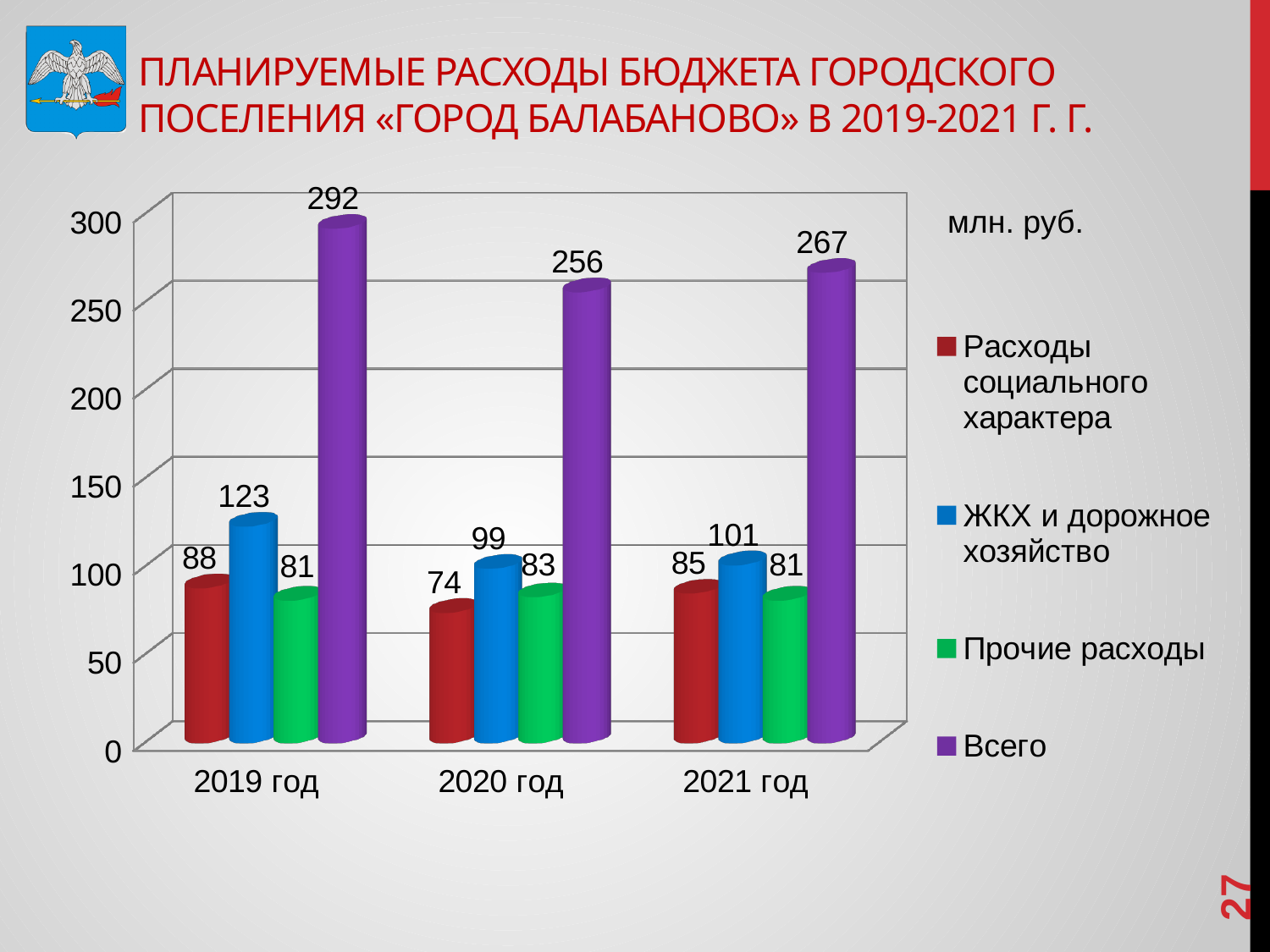
How many series does the legend list? 4 What unit is indicated next to the chart? млн. руб. What is the value of «Всего» for 2019 год? 292 In which year is «Расходы социального характера» the lowest? 2020 год How many years are shown on the x axis? 3 What is the difference between «Всего» in 2019 год and 2020 год? 36 What is the value of «Расходы социального характера» for 2021 год? 85 What kind of chart is shown on the slide? Bar chart Which is larger: «ЖКХ и дорожное хозяйство» in 2019 год or in 2021 год? 2019 год What is the value of «Прочие расходы» for 2020 год? 83 In which year is «Всего» the highest? 2019 год What is the value of «ЖКХ и дорожное хозяйство» for 2020 год? 99